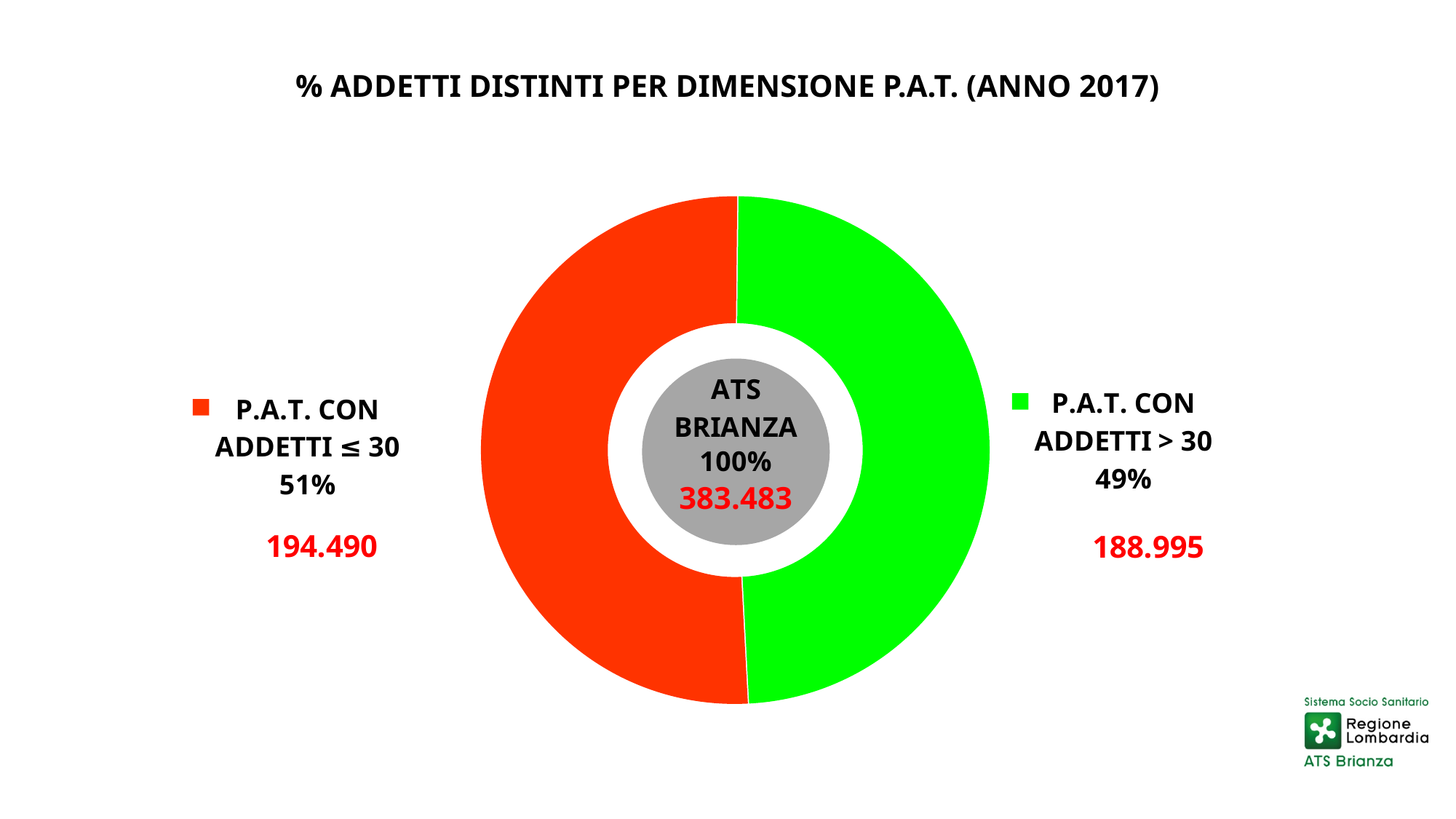
What kind of chart is shown on the slide? Donut (pie) chart How many categories does the chart show? 2 What percentage share is shown for P.A.T. CON ADDETTI ≤ 30? 51% What is the difference in addetti between P.A.T. CON ADDETTI ≤ 30 and P.A.T. CON ADDETTI > 30? 5.495 Which category has the smaller share of addetti? P.A.T. CON ADDETTI > 30 Which colour represents P.A.T. CON ADDETTI > 30? Green What percentage share is shown for P.A.T. CON ADDETTI > 30? 49% What is the number of addetti shown for P.A.T. CON ADDETTI > 30? 188.995 What is the number of addetti shown for P.A.T. CON ADDETTI ≤ 30? 194.490 What is the title of the chart? % ADDETTI DISTINTI PER DIMENSIONE P.A.T. (ANNO 2017) What total number of addetti is shown in the centre of the chart for ATS Brianza? 383.483 Which category has the larger share of addetti? P.A.T. CON ADDETTI ≤ 30